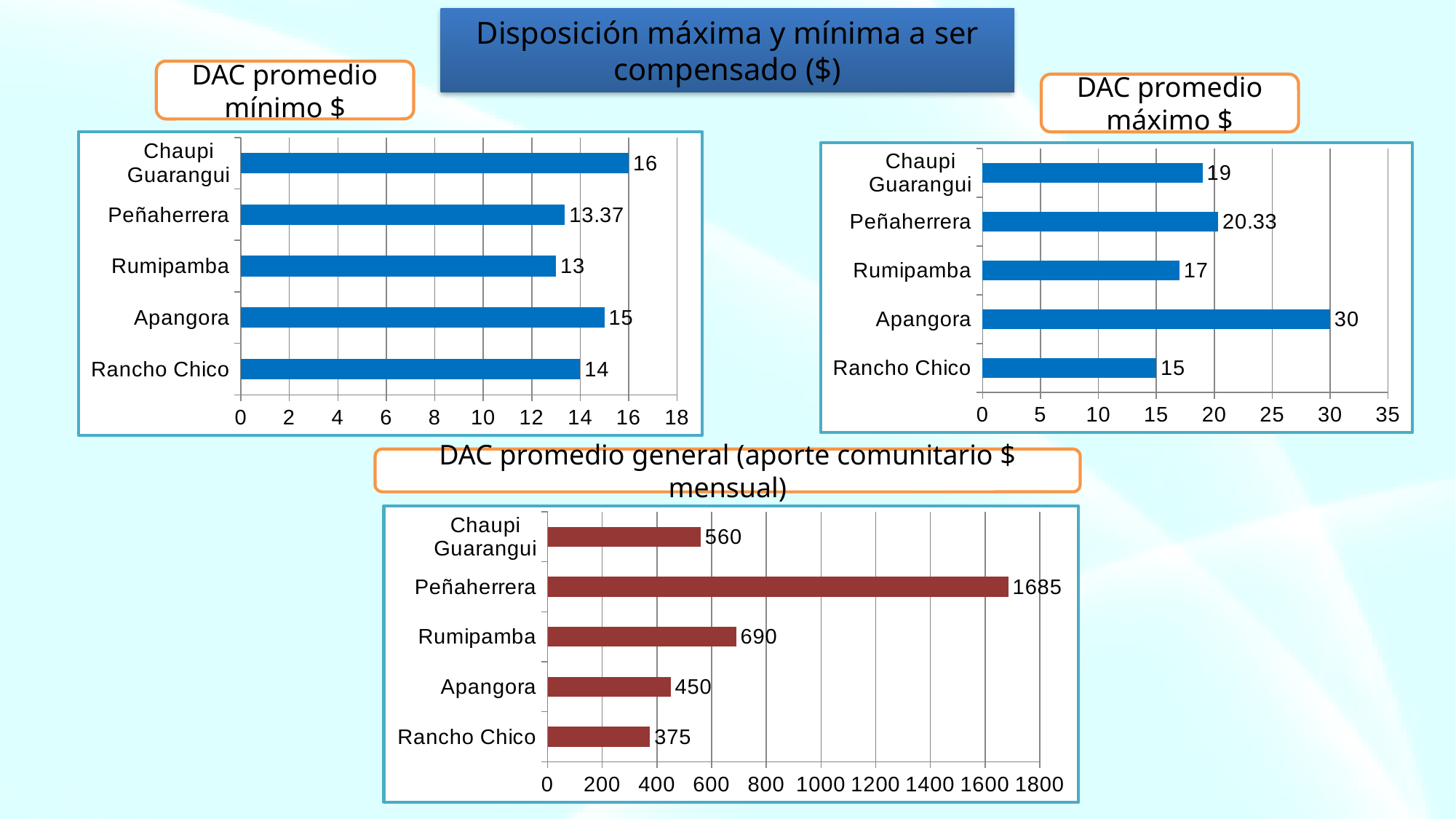
In the 'DAC promedio general (aporte comunitario $ mensual)' chart, what is the value for Peñaherrera? 1685 In the 'DAC promedio general (aporte comunitario $ mensual)' chart, what is the difference between the values for Rumipamba and Chaupi Guarangui? 130 In the 'DAC promedio mínimo $' chart, what is the value for Peñaherrera? 13.37 In the 'DAC promedio máximo $' chart, what is the difference between the values for Apangora and Rumipamba? 13 In the 'DAC promedio mínimo $' chart, which category has the lowest value? Rumipamba In the 'DAC promedio máximo $' chart, which category has the lowest value? Rancho Chico In the 'DAC promedio mínimo $' chart, which category has the highest value? Chaupi Guarangui In the 'DAC promedio general (aporte comunitario $ mensual)' chart, which is larger, the value for Apangora or the value for Rancho Chico? Apangora How many categories are shown in the 'DAC promedio mínimo $' chart? 5 What kind of chart is the 'DAC promedio general (aporte comunitario $ mensual)' chart? Bar chart In the 'DAC promedio general (aporte comunitario $ mensual)' chart, which category has the lowest value? Rancho Chico In the 'DAC promedio máximo $' chart, what is the value for Apangora? 30